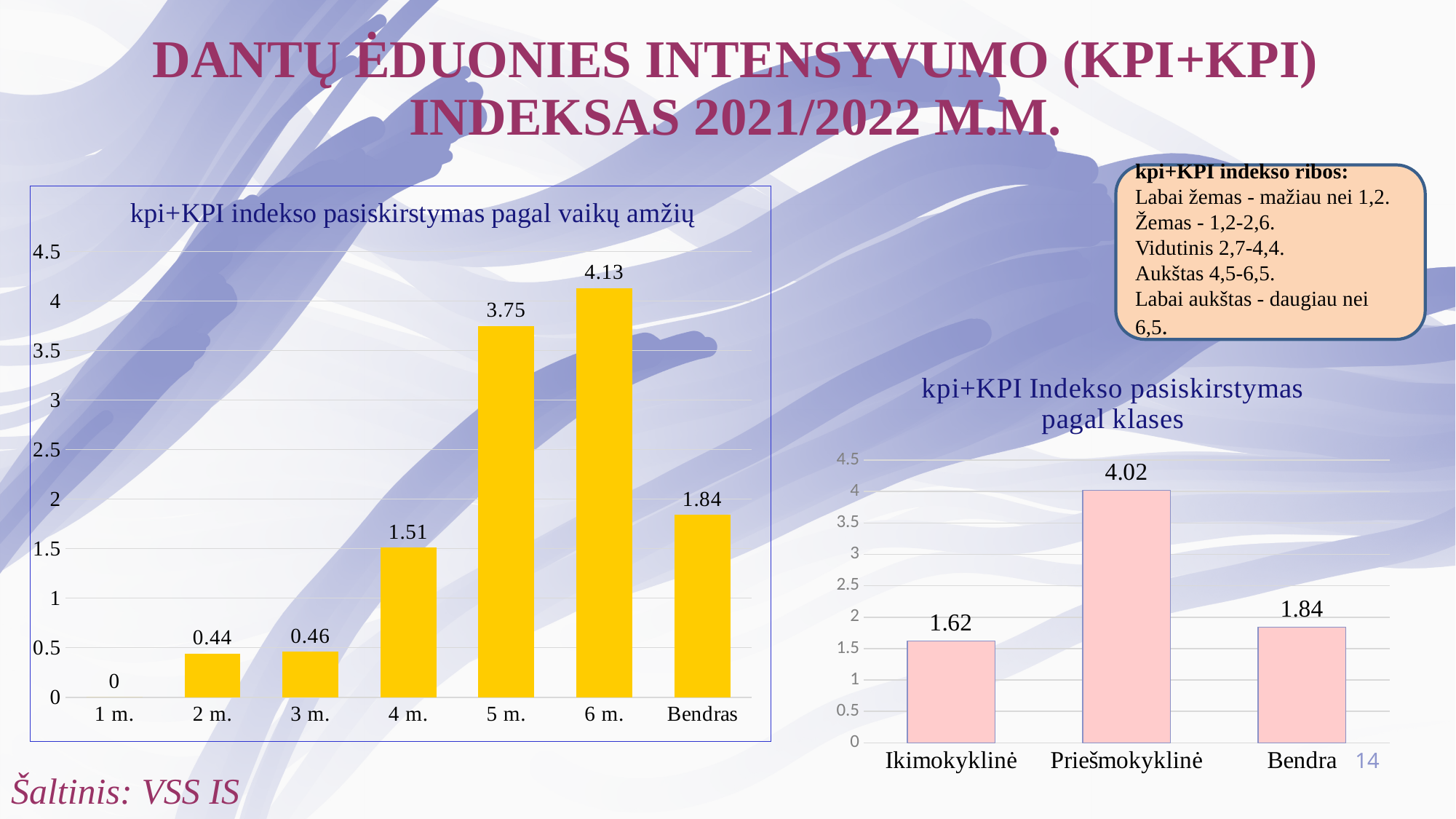
In the chart 'kpi+KPI indekso pasiskirstymas pagal vaikų amžių', what is the difference between the values for 6 m. and 4 m.? 2.62 In the chart 'kpi+KPI Indekso pasiskirstymas pagal klases', which is larger, the value for Bendra or the value for Ikimokyklinė? Bendra In the chart 'kpi+KPI Indekso pasiskirstymas pagal klases', what is the value for Priešmokyklinė? 4.02 In the chart 'kpi+KPI indekso pasiskirstymas pagal vaikų amžių', do the values rise or fall from 1 m. to 6 m.? rise In the chart 'kpi+KPI Indekso pasiskirstymas pagal klases', which category has the lowest value? Ikimokyklinė In the chart 'kpi+KPI indekso pasiskirstymas pagal vaikų amžių', which category has the lowest value? 1 m. In the chart 'kpi+KPI indekso pasiskirstymas pagal vaikų amžių', what is the value for 5 m.? 3.75 In the chart 'kpi+KPI indekso pasiskirstymas pagal vaikų amžių', what is the value for Bendras? 1.84 What kind of chart is 'kpi+KPI Indekso pasiskirstymas pagal klases'? bar chart In the chart 'kpi+KPI indekso pasiskirstymas pagal vaikų amžių', how many categories are shown on the x axis? 7 In the chart 'kpi+KPI Indekso pasiskirstymas pagal klases', what is the difference between the values for Priešmokyklinė and Ikimokyklinė? 2.4 In the chart 'kpi+KPI indekso pasiskirstymas pagal vaikų amžių', which category has the highest value? 6 m.